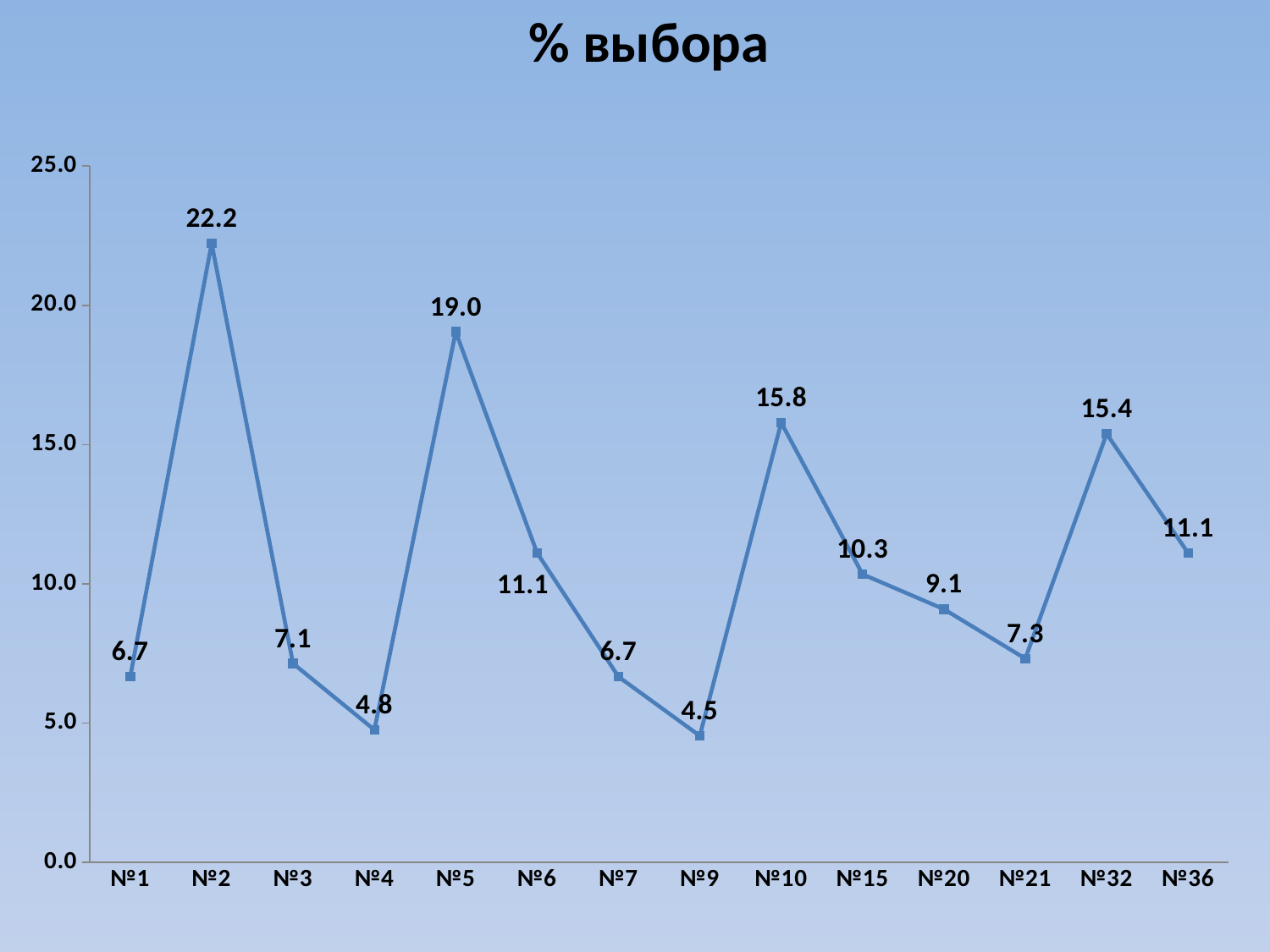
What is the difference between the values for №32 and №21? 8.1 How many categories are shown on the x axis? 14 Which category has the highest value? №2 What is the value for №10? 15.8 What is the value for №36? 11.1 What is the value for №2? 22.2 What type of chart is shown on the slide? line chart What is the difference between the values for №2 and №5? 3.2 Which category has the lowest value? №9 Is the value for №5 greater or less than 15.0? greater Which is larger, the value for №15 or the value for №20? №15 What is the title of the chart? % выбора